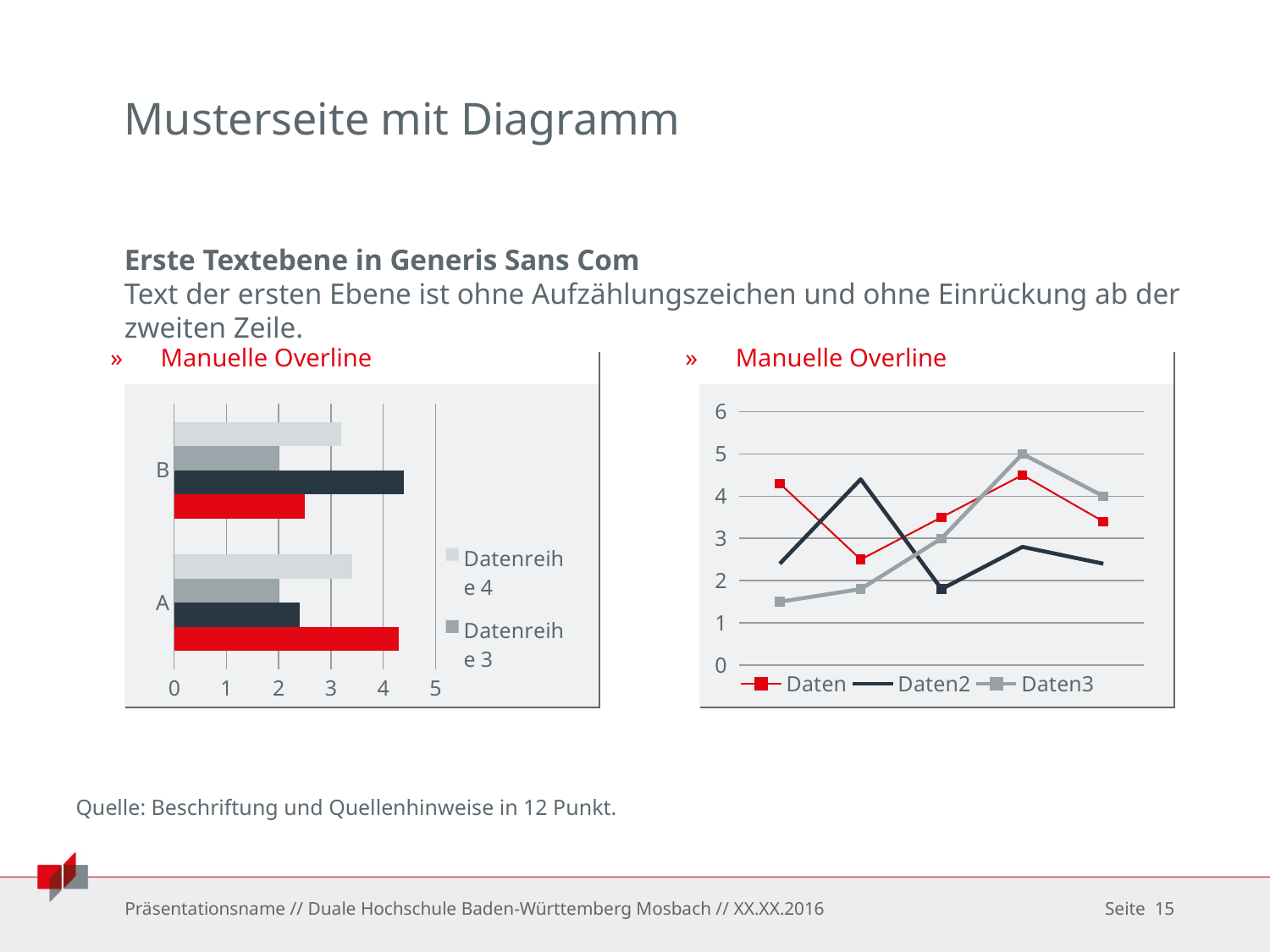
In the right-hand line chart, what is the highest value reached by the Daten3 series? 5 In the left-hand bar chart, is the red bar for category A greater or less than 4? greater In the right-hand line chart, is the first value of the Daten series greater or less than 4? greater What kind of chart is the chart on the left of the slide? bar chart In the right-hand line chart, does the Daten3 series rise or fall over its first four points? rise How many series does the legend of the right-hand line chart list? 3 Which series names are shown in the legend of the left-hand bar chart? Datenreihe 4 and Datenreihe 3 In the right-hand line chart, is the first value of the Daten3 series greater or less than 2? less What kind of chart is the chart on the right of the slide? line chart How many categories are shown on the vertical axis of the left-hand bar chart? 2 In the right-hand line chart, which series has the lowest value at the first point? Daten3